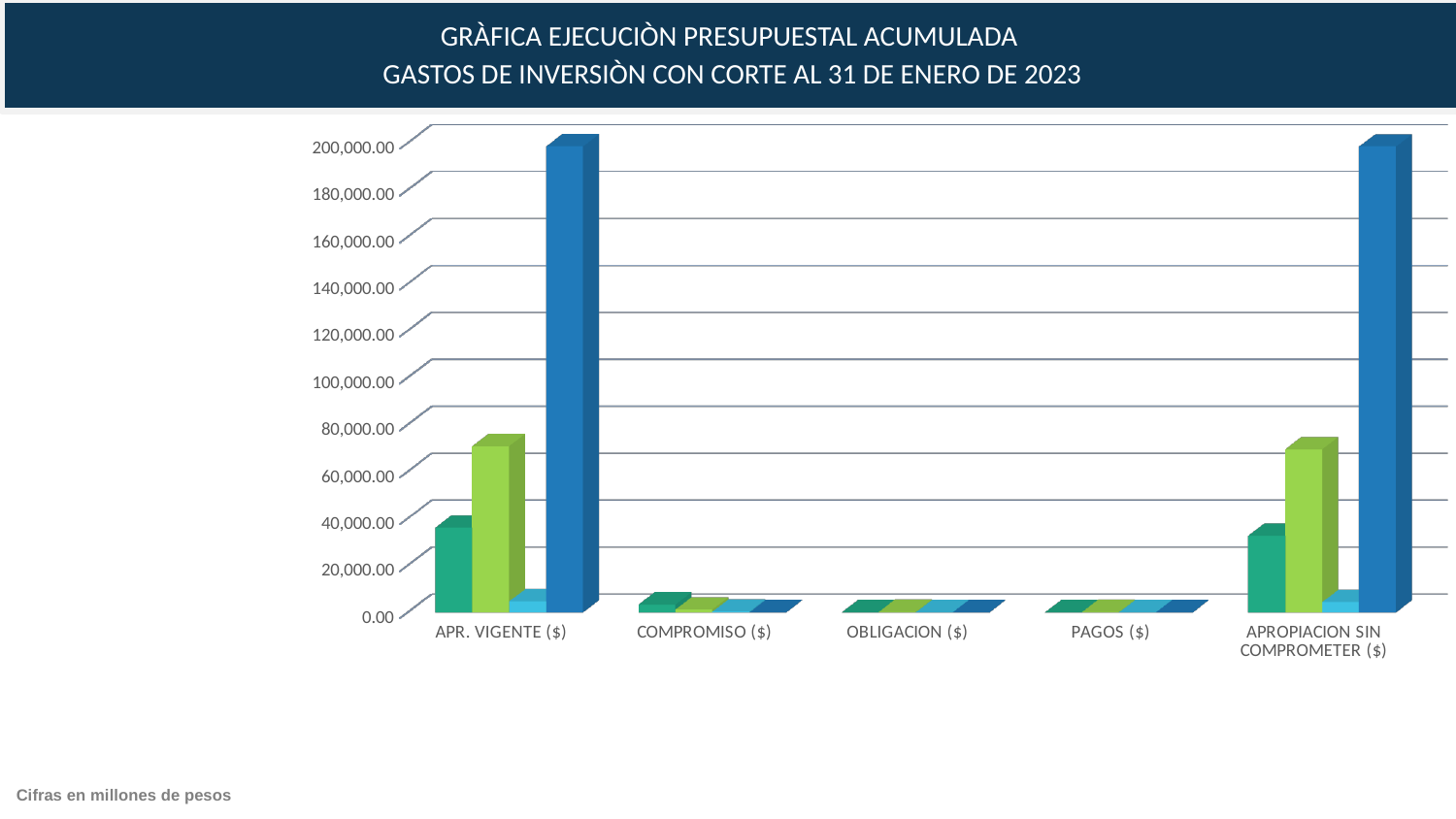
Is the value of the lime green bar for APR. VIGENTE ($) greater or less than 60,000.00? greater How many categories are shown along the x axis of the chart? 5 What kind of chart is shown on the slide? bar chart How many bars are plotted for the APR. VIGENTE ($) category? 4 Is the value of the dark blue bar for COMPROMISO ($) greater or less than 20,000.00? less Is the value of the light blue bar for APR. VIGENTE ($) greater or less than 20,000.00? less Which category has the larger teal bar: APR. VIGENTE ($) or COMPROMISO ($)? APR. VIGENTE ($) Which is larger for APR. VIGENTE ($): the dark blue bar or the lime green bar? the dark blue bar What is the highest value shown on the vertical axis of the chart? 200,000.00